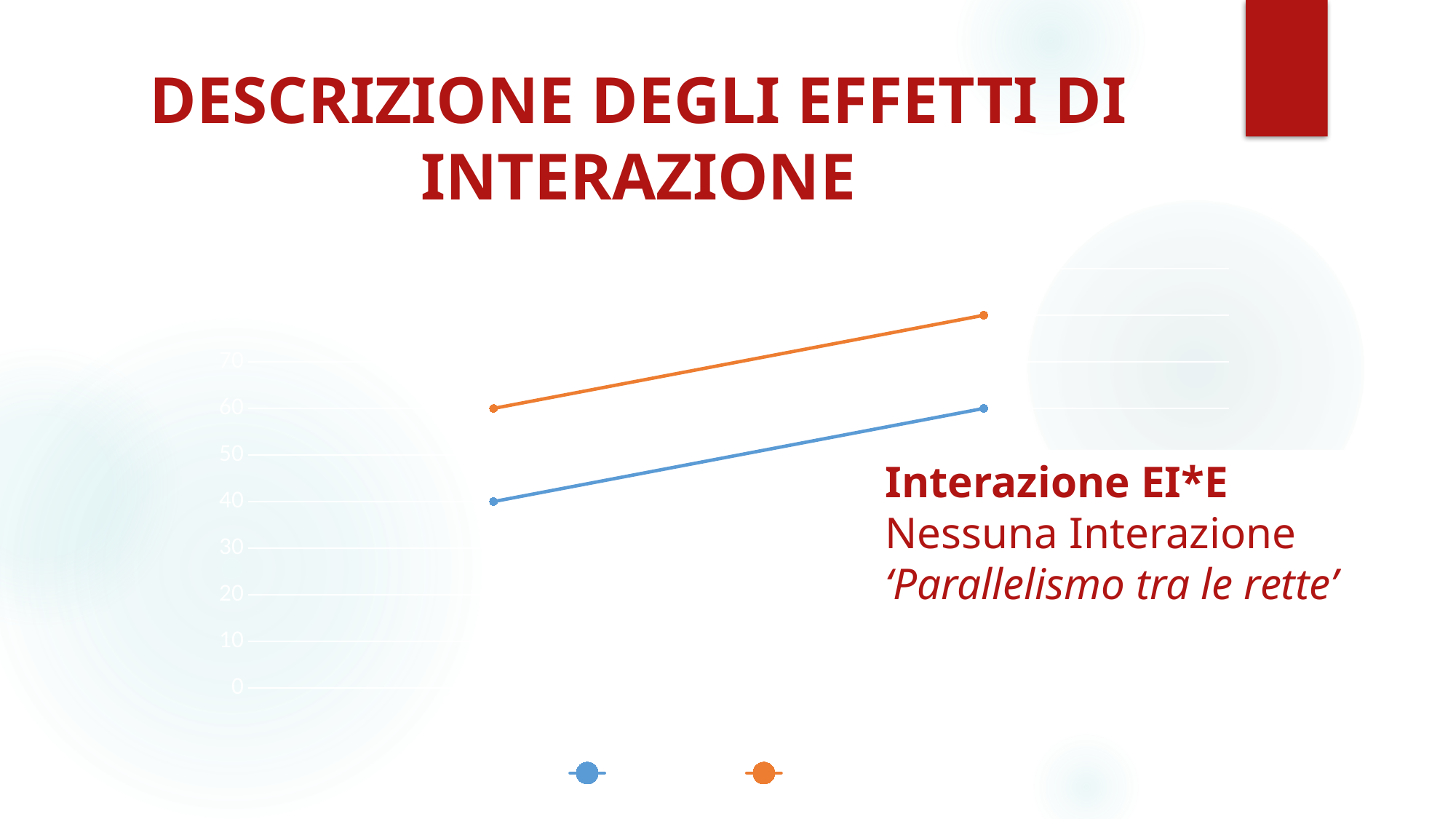
According to the text next to the chart, what does the parallelism between the lines indicate about the EI*E interaction? Nessuna Interazione Is the right point of the blue line greater or less than 50? greater Is the left point of the orange line greater or less than 50? greater How many data points does each line in the chart have? 2 Does the blue line rise or fall from left to right? rise Is the right point of the orange line greater or less than 70? greater How many series does the legend below the chart show? 2 What kind of chart is shown on the slide? line chart Which line is higher on the chart, the orange line or the blue line? orange line Does the orange line rise or fall from left to right? rise What are the two colours of the lines plotted in the chart? blue and orange